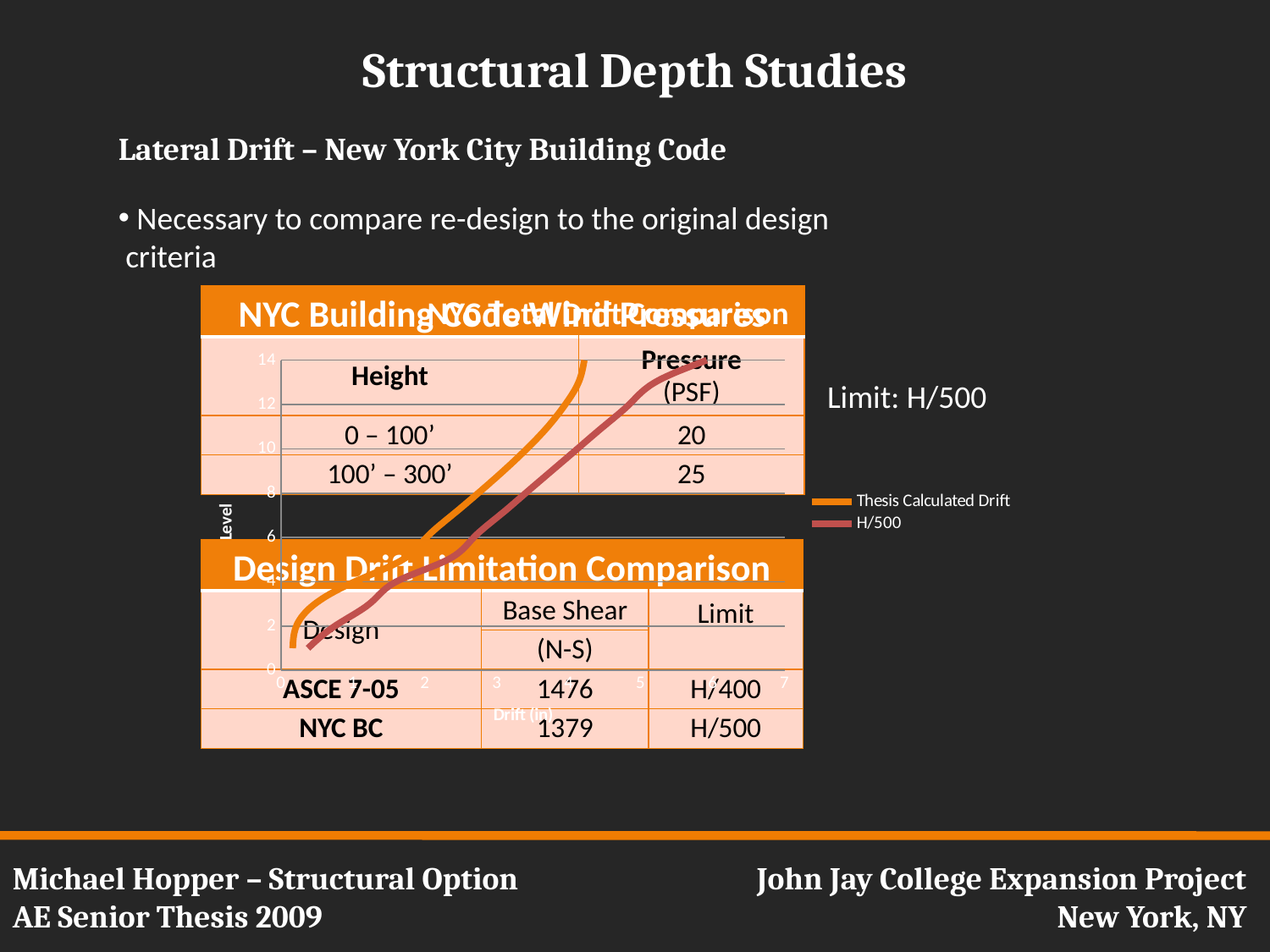
What is the label of the chart's vertical axis? Level What is the highest value shown on the chart's horizontal axis (Drift (in))? 7 What is the highest value shown on the chart's vertical axis? 14 At level 10, which series shows the smaller drift, Thesis Calculated Drift or H/500? Thesis Calculated Drift At level 12, which series shows the greater drift, Thesis Calculated Drift or H/500? H/500 Which series is drawn in orange on the chart? Thesis Calculated Drift Does the level rise or fall as drift increases along the horizontal axis for both series? rise How many series does the chart legend list? 2 Is the Thesis Calculated Drift at level 14 greater or less than 6 inches? less What kind of chart is shown on the slide? line chart What are the two series named in the chart legend? Thesis Calculated Drift and H/500